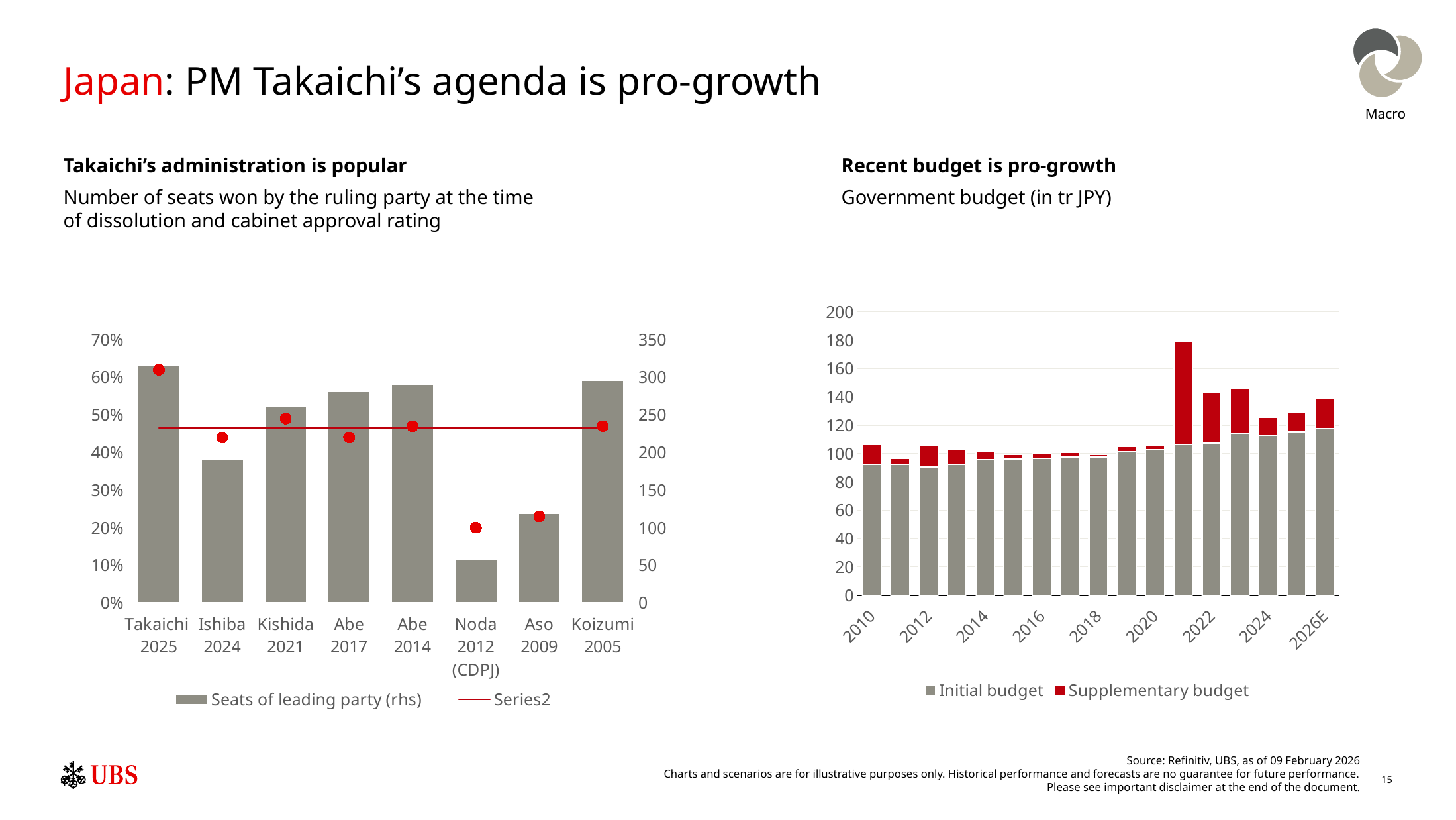
In the 'Recent budget is pro-growth' chart, is the total budget for 2021 greater or less than 160? greater How many series does the legend of the 'Recent budget is pro-growth' chart list? 2 In the 'Recent budget is pro-growth' chart, what colour represents the supplementary budget? red What kind of chart is the 'Recent budget is pro-growth' chart? stacked bar chart In the 'Takaichi's administration is popular' chart, which category has the lowest number of seats of the leading party? Noda 2012 (CDPJ) In the 'Takaichi's administration is popular' chart, which is larger: the seats of the leading party for Kishida 2021 or for Aso 2009? Kishida 2021 In the 'Recent budget is pro-growth' chart, which year has the highest total budget? 2021 In the 'Recent budget is pro-growth' chart, which is larger: the total budget for 2022 or for 2024? 2022 In the 'Takaichi's administration is popular' chart, is the number of seats for Ishiba 2024 greater or less than 200? less In the 'Recent budget is pro-growth' chart, is the initial budget for 2010 greater or less than 100? less How many categories are shown on the x axis of the 'Takaichi's administration is popular' chart? 8